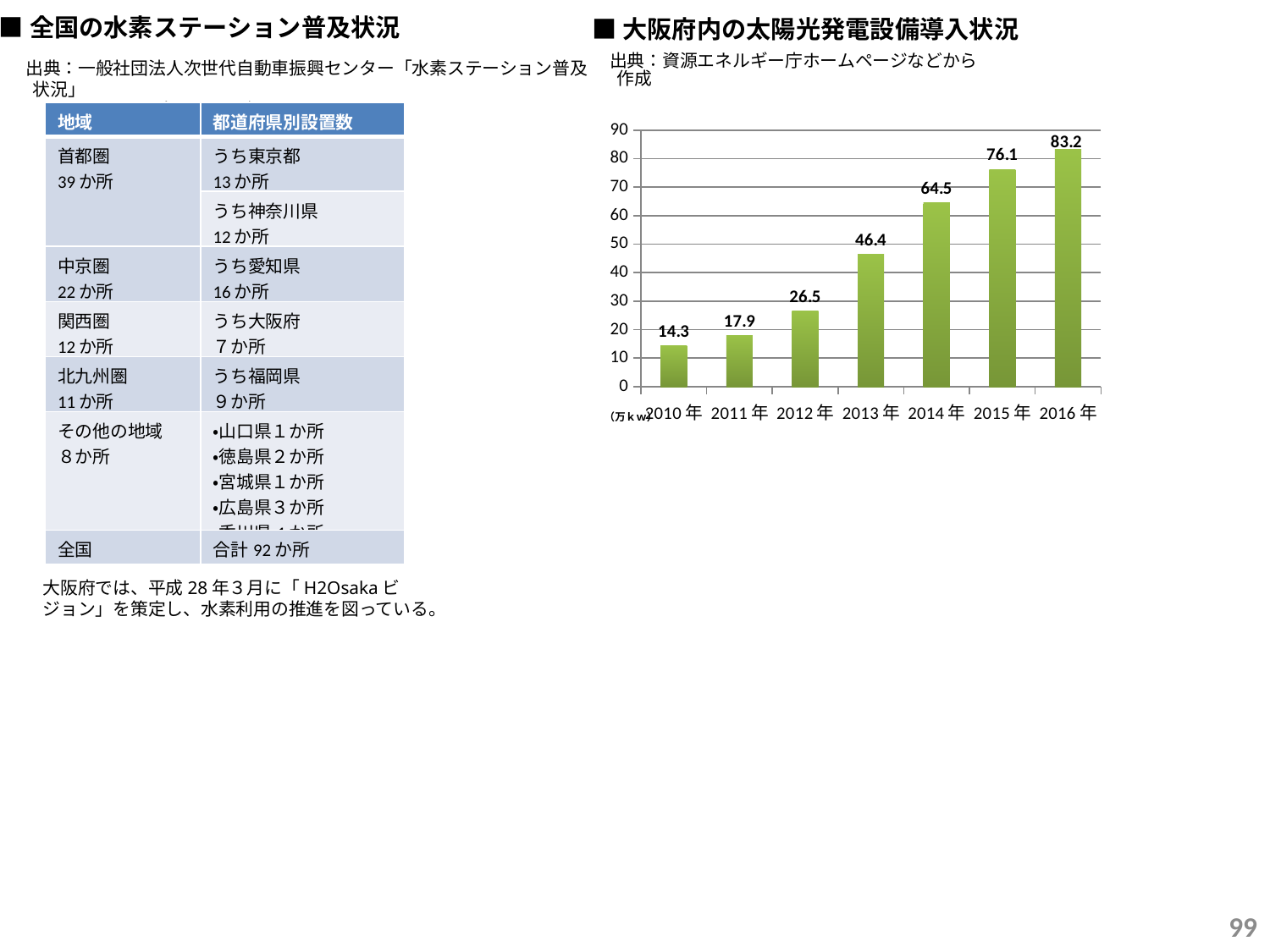
What is the difference between the values for 2016年 and 2015年 in the bar chart? 7.1 Which year has the lowest value in the bar chart? 2010年 What is the value for 2013年 in the bar chart? 46.4 How many years are shown in the bar chart? 7 What is the difference between the values for 2014年 and 2013年 in the bar chart? 18.1 What is the value for 2010年 in the bar chart? 14.3 Which year has the highest value in the bar chart? 2016年 What kind of chart is shown on the slide? bar chart Do the values in the bar chart rise or fall from 2010年 to 2016年? rise What is the value for 2016年 in the bar chart? 83.2 Is the value for 2014年 in the bar chart greater or less than 60? greater Which is larger in the bar chart, the value for 2012年 or the value for 2011年? 2012年